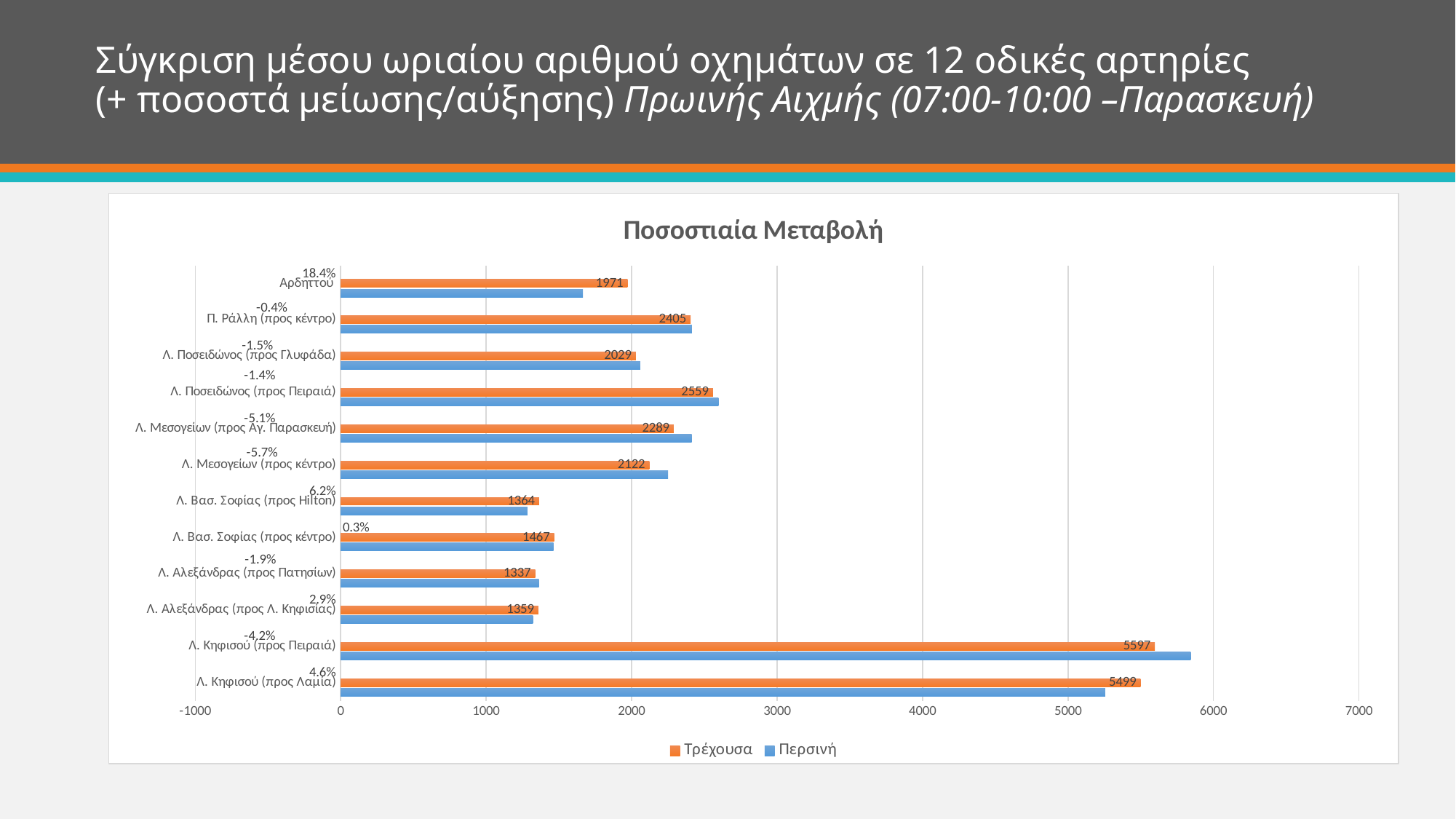
What is the Τρέχουσα value for Αρδηττού? 1971 Which is larger, the Τρέχουσα value for Π. Ράλλη (προς κέντρο) or for Λ. Μεσογείων (προς κέντρο)? Π. Ράλλη (προς κέντρο) Is the Περσινή value for Λ. Κηφισού (προς Πειραιά) greater or less than 5000? greater What is the Τρέχουσα value for Λ. Βασ. Σοφίας (προς κέντρο)? 1467 Which category has the highest Τρέχουσα value? Λ. Κηφισού (προς Πειραιά) What is the title of the chart? Ποσοστιαία Μεταβολή How many series does the legend list? 2 Which category has the lowest Τρέχουσα value? Λ. Αλεξάνδρας (προς Πατησίων) What is the Τρέχουσα value for Λ. Ποσειδώνος (προς Πειραιά)? 2559 What is the difference between the Τρέχουσα values for Λ. Κηφισού (προς Πειραιά) and Λ. Κηφισού (προς Λαμία)? 98 What type of chart is shown on the slide? bar chart How many road categories are plotted in the chart? 12